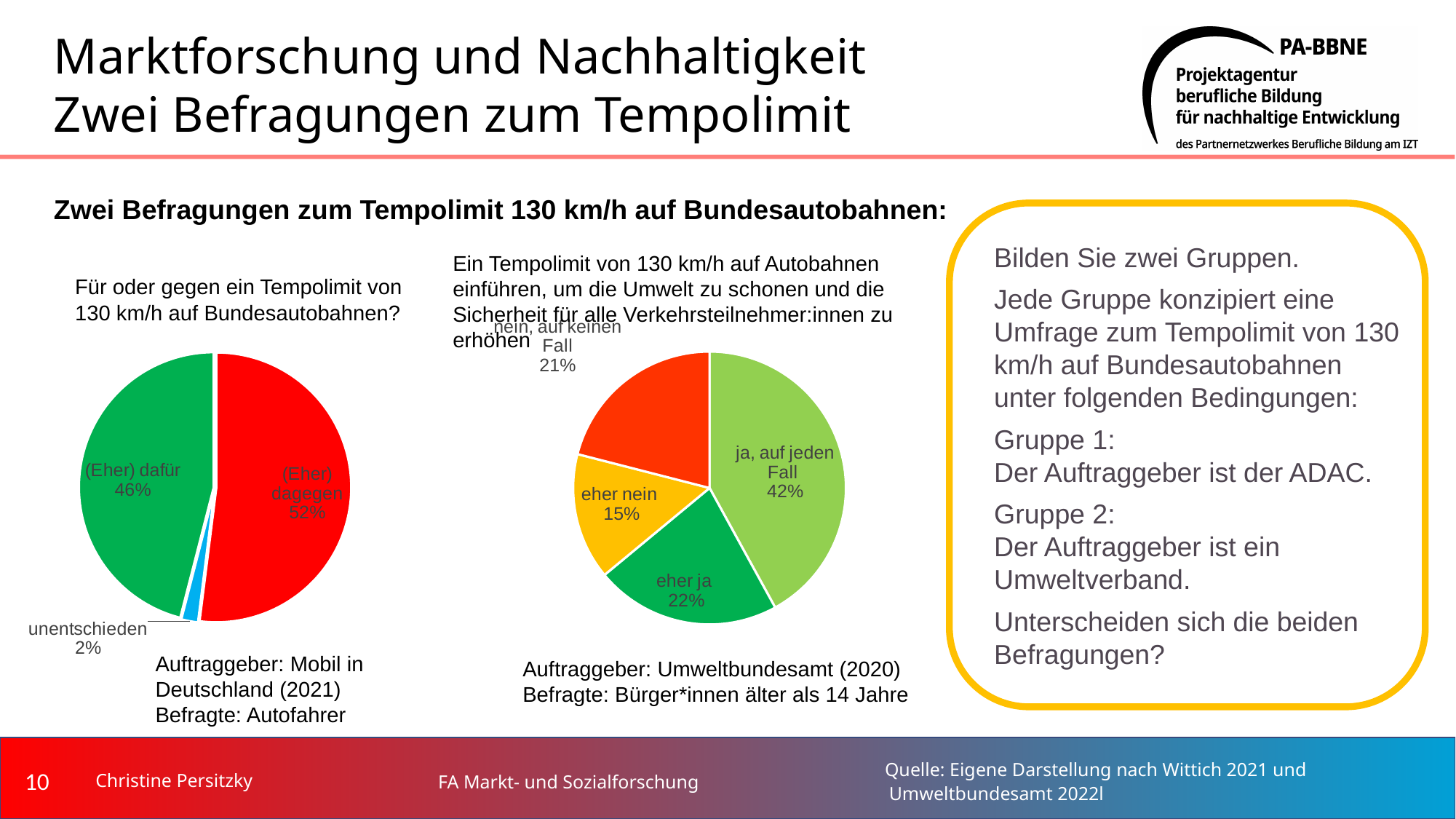
How many slices does the left pie chart have? 3 In the left pie chart, which category has the largest share? (Eher) dagegen In the left pie chart, what is the difference between the "(Eher) dagegen" and "(Eher) dafür" shares? 6 percentage points What kind of chart is the left chart on the slide? pie chart In the right pie chart, which category has the smallest share? eher nein In the left pie chart, what share of respondents answered "unentschieden"? 2% In the right pie chart, which is larger: "eher ja" or "nein, auf keinen Fall"? eher ja In the left pie chart, what share of respondents answered "(Eher) dafür"? 46% In the right pie chart, what share of respondents answered "ja, auf jeden Fall"? 42% How many slices does the right pie chart have? 4 In the right pie chart, what share of respondents answered "eher nein"? 15% In the left pie chart, what share of respondents answered "(Eher) dagegen"? 52%